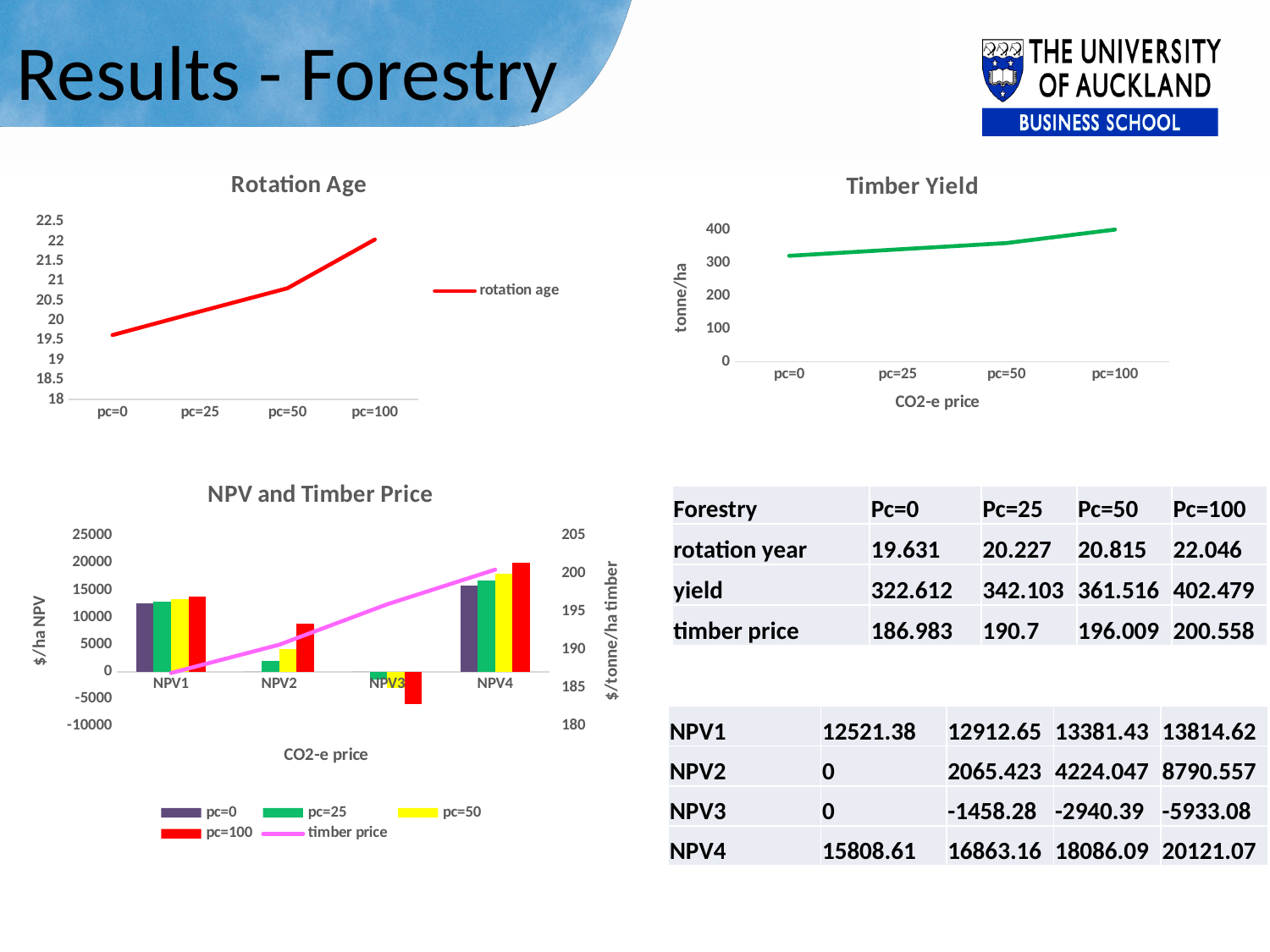
In the NPV and Timber Price chart, which category has the highest NPV bars? NPV4 What kind of chart is the Rotation Age chart? line chart In the Rotation Age chart, is the value for pc=100 greater or less than 21.5? greater How many series does the legend of the NPV and Timber Price chart list? 5 In the NPV and Timber Price chart, does the timber price line rise or fall from NPV1 to NPV4? rise In the Timber Yield chart, do the values rise or fall along the x axis? rise In the Rotation Age chart, do the values rise or fall from pc=0 to pc=100? rise How many points are plotted in the Rotation Age chart? 4 What is the y-axis label of the Timber Yield chart? tonne/ha In the Timber Yield chart, is the value for pc=0 greater or less than 400? less In the Rotation Age chart, is the value for pc=0 greater or less than 20? less